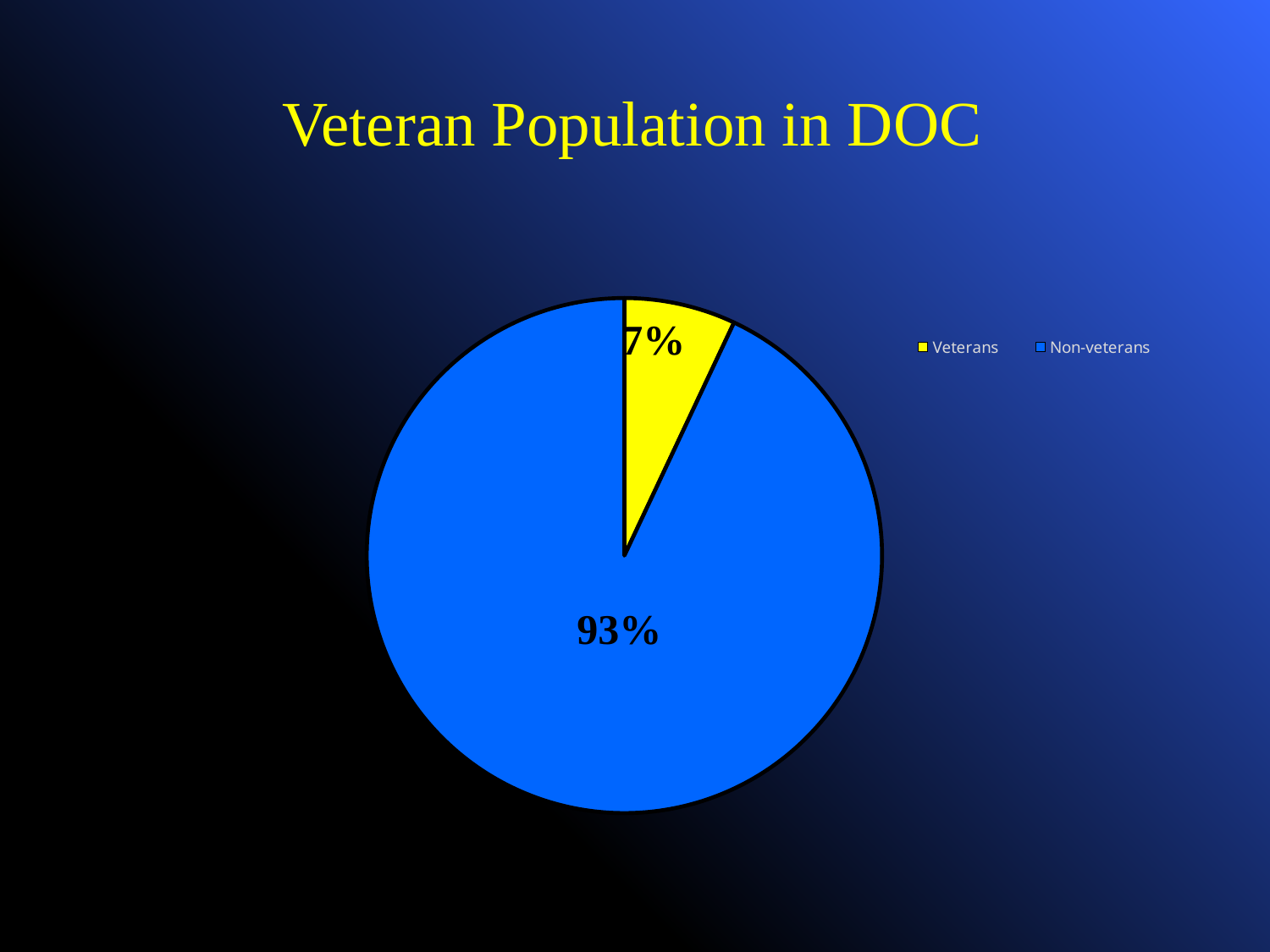
What share of the pie do Veterans make up? 7% What colour is the Veterans slice? yellow What is the title of the chart? Veteran Population in DOC How many categories does the pie chart show? 2 What kind of chart is shown on the slide? pie chart What is the difference in percentage points between the Non-veterans and Veterans slices? 86 Which category has the smallest slice of the pie? Veterans How many entries does the legend list? 2 Which category has the largest slice of the pie? Non-veterans Which is larger, the Veterans slice or the Non-veterans slice? Non-veterans What share of the pie do Non-veterans make up? 93%